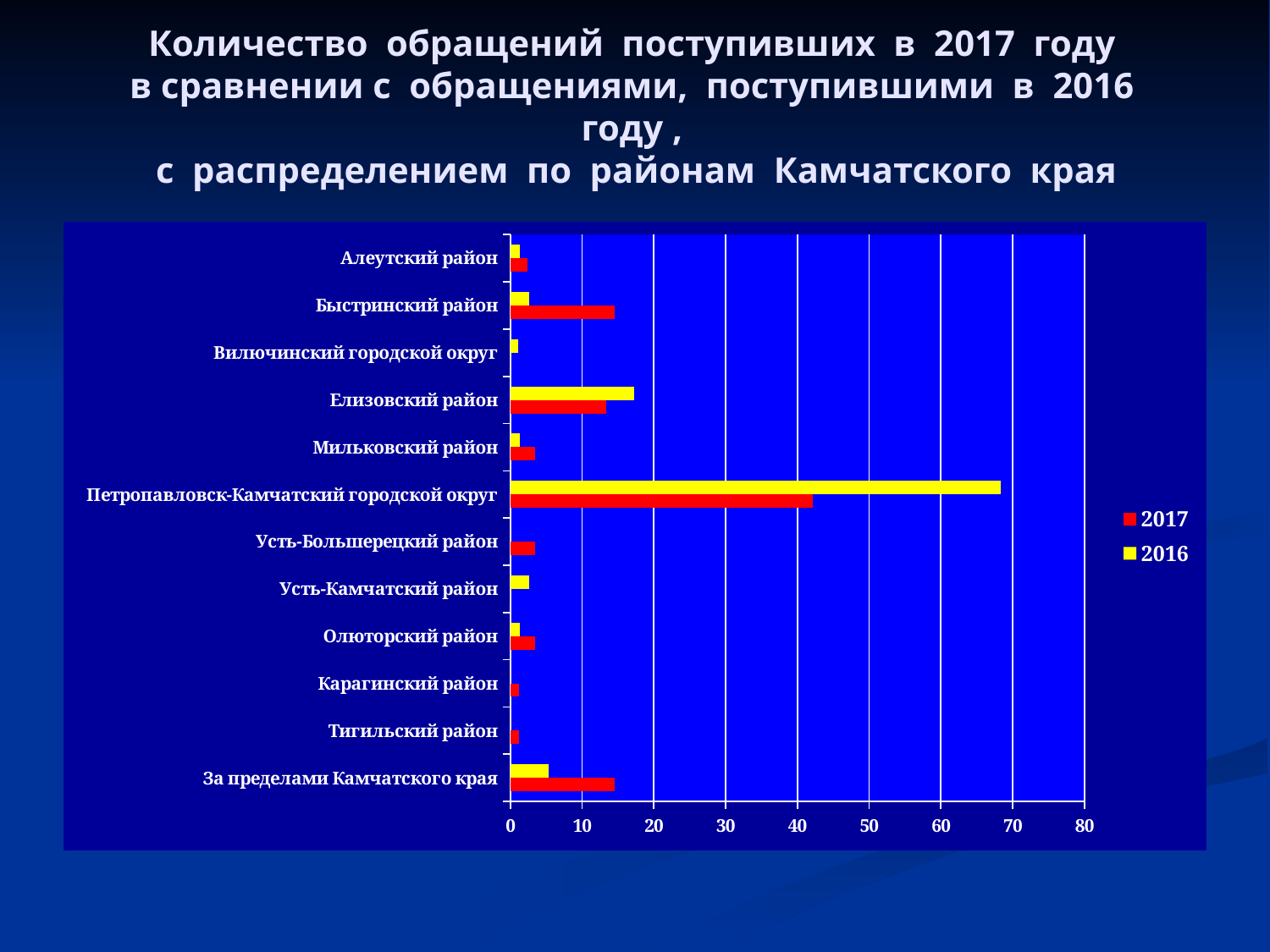
For Быстринский район, which year has the larger value, 2016 or 2017? 2017 How many districts (categories) are shown on the chart? 12 For Елизовский район, which year has the larger value, 2016 or 2017? 2016 What kind of chart is shown on the slide? bar chart Is the 2016 value for Елизовский район greater or less than 20? less Which category has the highest value for 2016? Петропавловск-Камчатский городской округ Which category has the highest value for 2017? Петропавловск-Камчатский городской округ How many series does the legend list? 2 Which colour represents the 2016 series in the legend? yellow For Петропавловск-Камчатский городской округ, which year has the larger value, 2016 or 2017? 2016 Is the 2017 value for Петропавловск-Камчатский городской округ greater or less than 30? greater Is the 2016 value for Петропавловск-Камчатский городской округ greater or less than 60? greater